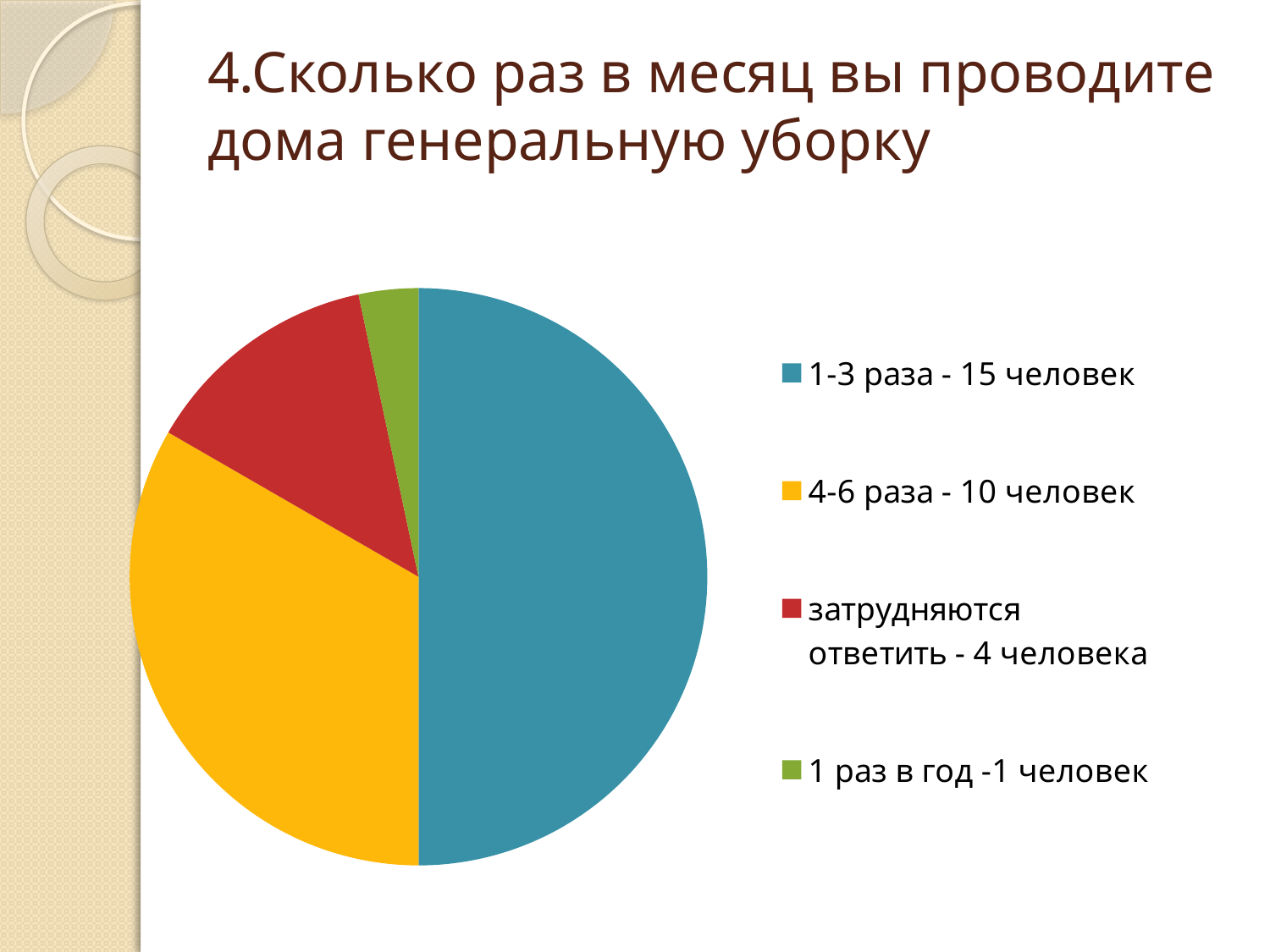
How many slices does the pie chart have? 4 How many people answered "1 раз в год"? 1 человек What kind of chart is shown on the slide? pie chart Which answer option has the smallest slice of the pie? 1 раз в год What is the difference between the number of people who answered "1-3 раза" and those who answered "4-6 раза"? 5 How many people answered "затрудняются ответить"? 4 человека What share of the pie does the "1-3 раза" slice represent? 50% Which answer option has the largest slice of the pie? 1-3 раза How many people answered "4-6 раза"? 10 человек Which is larger: the number of people who answered "4-6 раза" or "затрудняются ответить"? 4-6 раза What colour is the slice for "затрудняются ответить"? red How many people answered "1-3 раза"? 15 человек